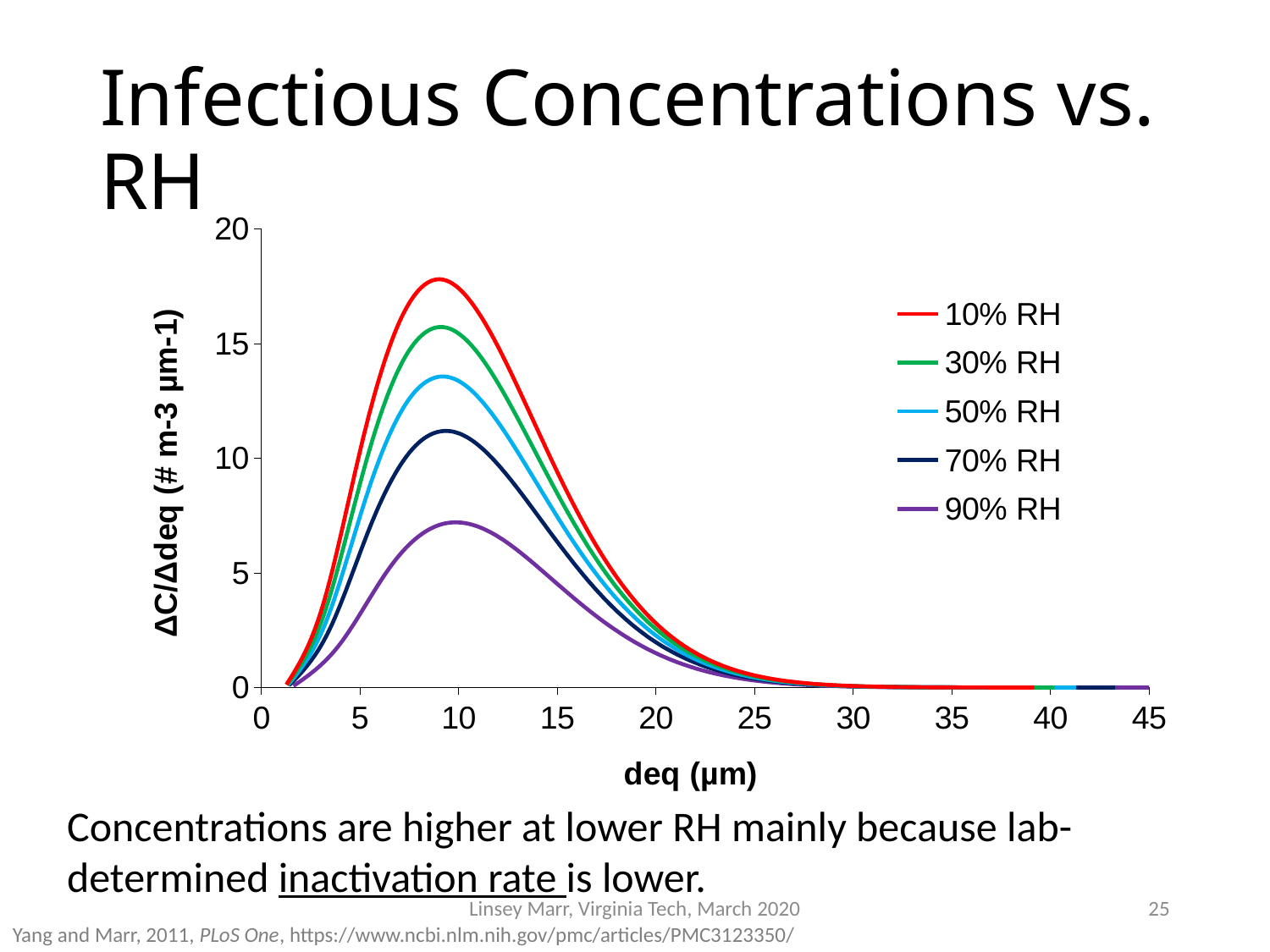
Which curve has a higher peak, 30% RH or 50% RH? 30% RH Is the peak value of the 50% RH curve greater or less than 10? greater Is the peak value of the 10% RH curve greater or less than 15? greater What kind of chart is shown on the slide? line chart What is the label of the x axis? deq (µm) Which series reaches the highest peak value? 10% RH Is the peak value of the 90% RH curve greater or less than 10? less What colour is the 10% RH line? red How many series does the legend list? 5 Which series has the lowest peak value? 90% RH After reaching their peaks near deq of 10 µm, do the curves rise or fall as deq increases? fall